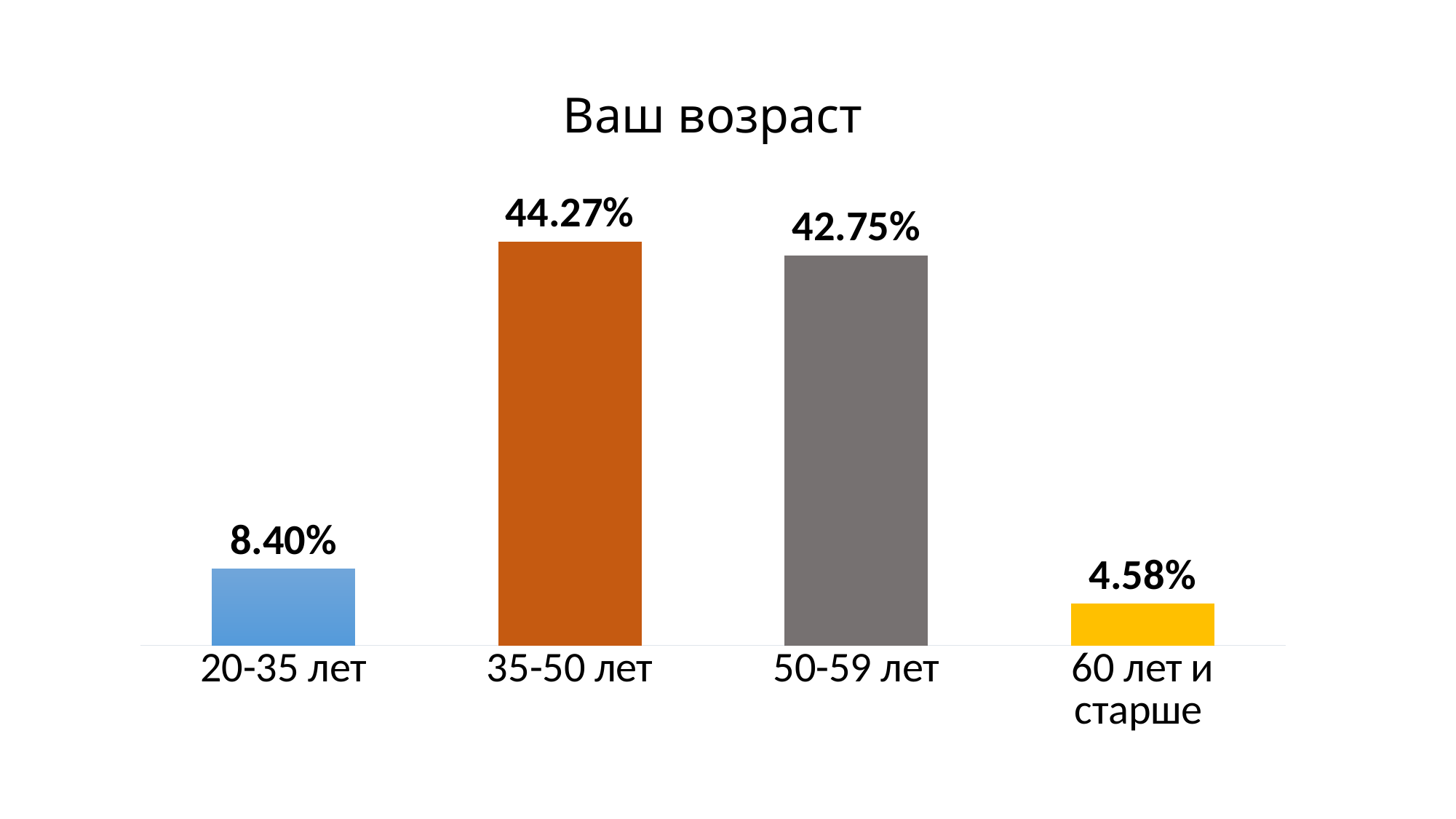
Which category has the highest value? 35-50 лет What is the value for the 60 лет и старше category? 4.58% Which is larger, the value for 20-35 лет or the value for 60 лет и старше? 20-35 лет Which category has the lowest value? 60 лет и старше What kind of chart is shown on the slide? Bar chart What is the value for the 50-59 лет category? 42.75% What is the difference between the values for 35-50 лет and 50-59 лет? 1.52% What is the difference between the values for 20-35 лет and 60 лет и старше? 3.82% What is the value for the 35-50 лет category? 44.27% How many categories are shown in the chart? 4 What is the title of the chart? Ваш возраст What is the value for the 20-35 лет category? 8.40%